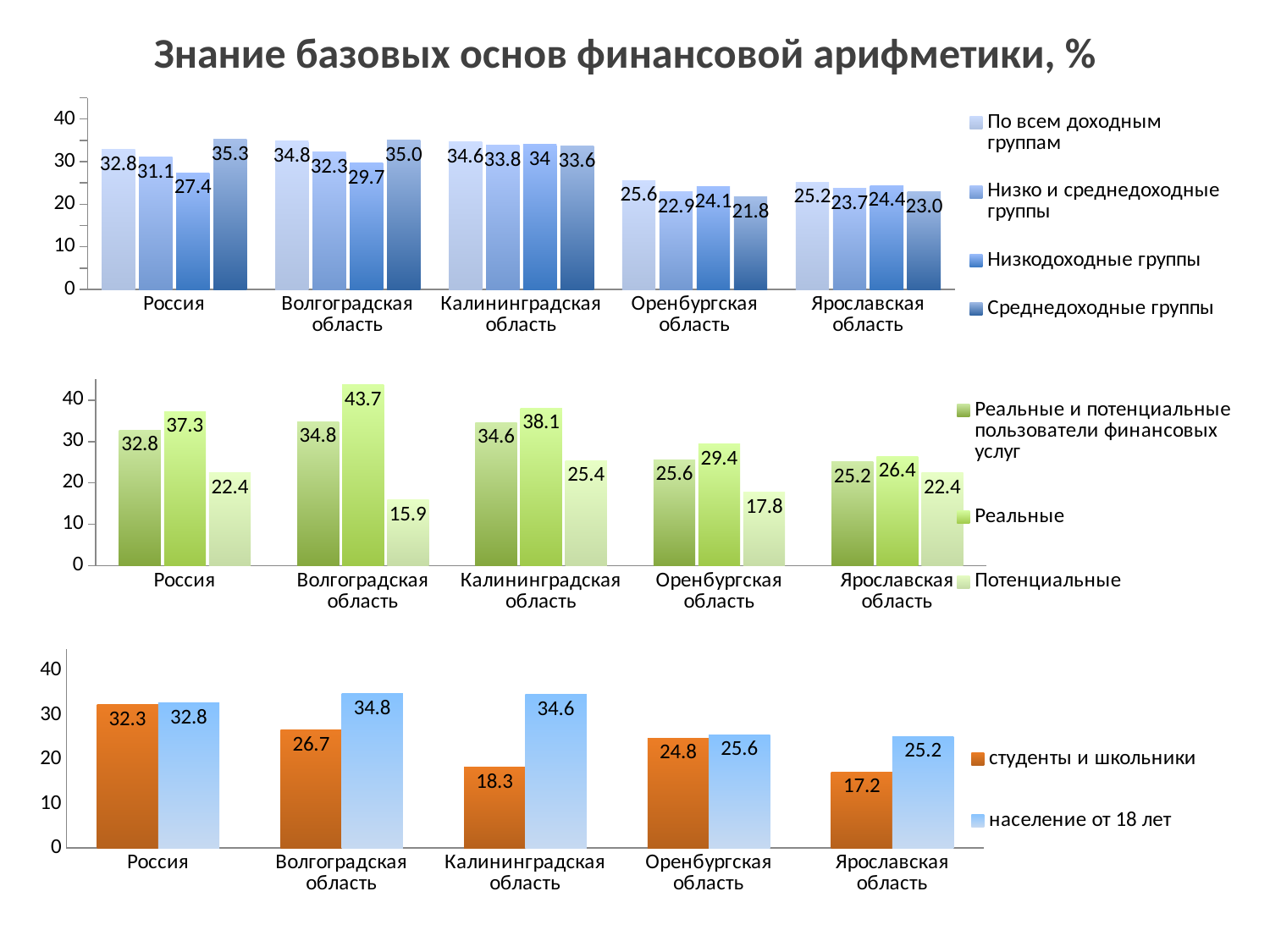
In the middle chart, which is larger in Ярославская область: Реальные or Потенциальные? Реальные In the top chart, which region has the lowest value for Среднедоходные группы? Оренбургская область In the bottom chart, what is the difference between население от 18 лет and студенты и школьники in Калининградская область? 16.3 In the bottom chart, which region has the highest value for население от 18 лет? Волгоградская область In the middle chart, which region has the lowest value for Потенциальные? Волгоградская область What type of chart is the bottom chart? Bar chart How many series does the legend of the top chart list? 4 In the top chart, what is the value for Низкодоходные группы in Россия? 27.4 How many regions are shown on the x axis of the bottom chart? 5 In the bottom chart, what is the value for студенты и школьники in Калининградская область? 18.3 In the middle chart, what is the value for Реальные in Волгоградская область? 43.7 In the middle chart, what is the difference between Реальные and Потенциальные in Калининградская область? 12.7